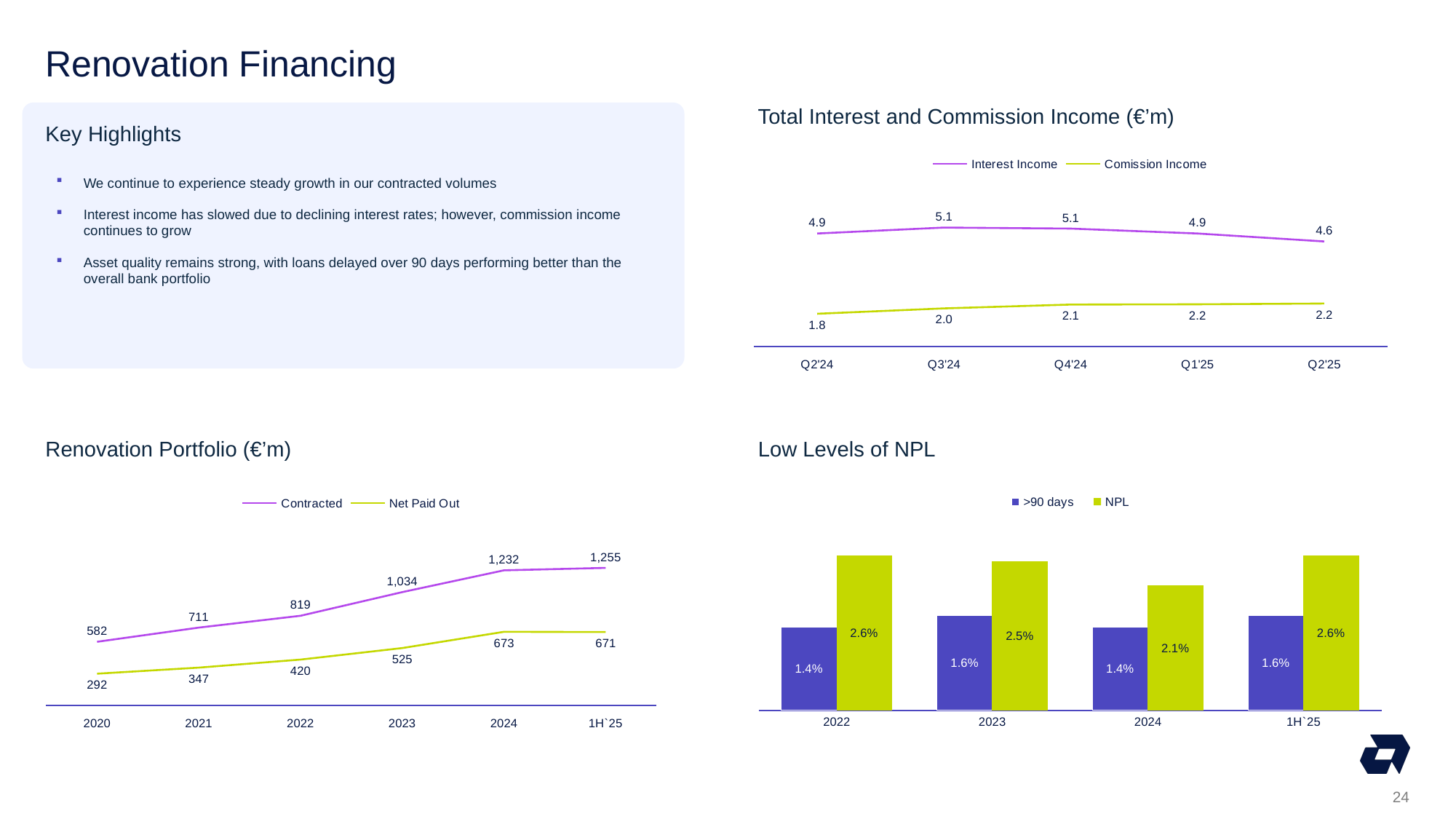
In the 'Low Levels of NPL' chart, which year has the lowest NPL value? 2024 What kind of chart is 'Low Levels of NPL'? bar chart In the 'Renovation Portfolio (€'m)' chart, does the Contracted series rise or fall from 2020 to 1H`25? rise In the 'Low Levels of NPL' chart, what is the NPL value for 2024? 2.1% In the 'Low Levels of NPL' chart, what is the >90 days value for 2023? 1.6% In the 'Total Interest and Commission Income (€'m)' chart, what is the Interest Income value for Q3'24? 5.1 In the 'Renovation Portfolio (€'m)' chart, how many periods are shown on the x axis? 6 In the 'Total Interest and Commission Income (€'m)' chart, how many series does the legend list? 2 In the 'Total Interest and Commission Income (€'m)' chart, what is the Comission Income value for Q2'24? 1.8 In the 'Renovation Portfolio (€'m)' chart, what is the difference between Contracted and Net Paid Out in 1H`25? 584 In the 'Total Interest and Commission Income (€'m)' chart, which quarter has the lowest Interest Income? Q2'25 In the 'Renovation Portfolio (€'m)' chart, what is the Contracted value for 2023? 1,034